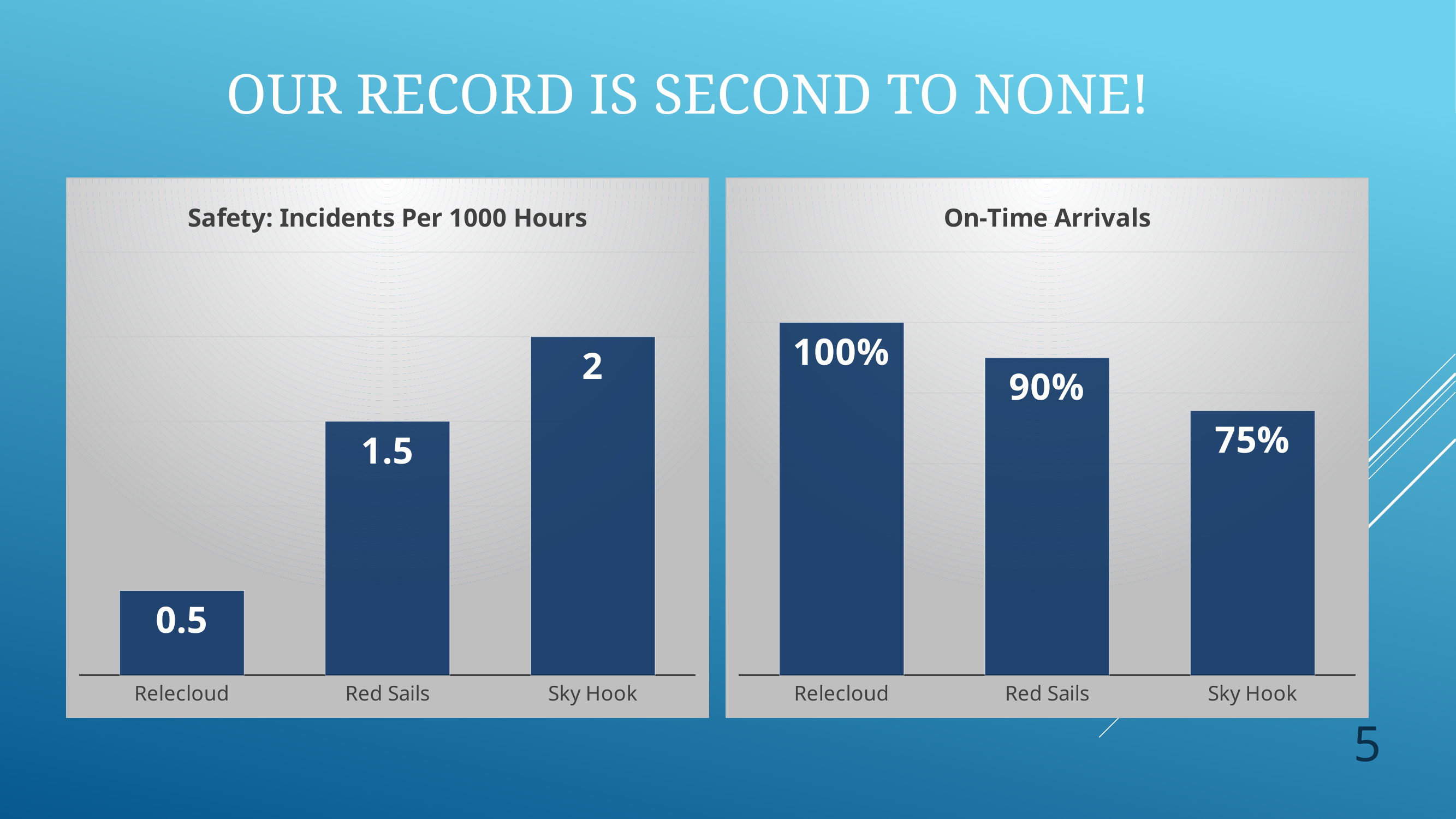
In the 'On-Time Arrivals' chart, what is the difference between the values for Relecloud and Sky Hook? 25% In the 'On-Time Arrivals' chart, which is larger, the value for Red Sails or the value for Sky Hook? Red Sails In the 'Safety: Incidents Per 1000 Hours' chart, what is the difference between the values for Sky Hook and Relecloud? 1.5 In the 'Safety: Incidents Per 1000 Hours' chart, what is the value for Relecloud? 0.5 In the 'Safety: Incidents Per 1000 Hours' chart, which category has the highest value? Sky Hook In the 'Safety: Incidents Per 1000 Hours' chart, do the values rise or fall from left to right? rise In the 'On-Time Arrivals' chart, which category has the highest value? Relecloud In the 'Safety: Incidents Per 1000 Hours' chart, what is the value for Red Sails? 1.5 In the 'On-Time Arrivals' chart, what is the value for Sky Hook? 75% What kind of chart is the 'On-Time Arrivals' chart? bar chart In the 'Safety: Incidents Per 1000 Hours' chart, which category has the lowest value? Relecloud In the 'On-Time Arrivals' chart, what is the value for Red Sails? 90%